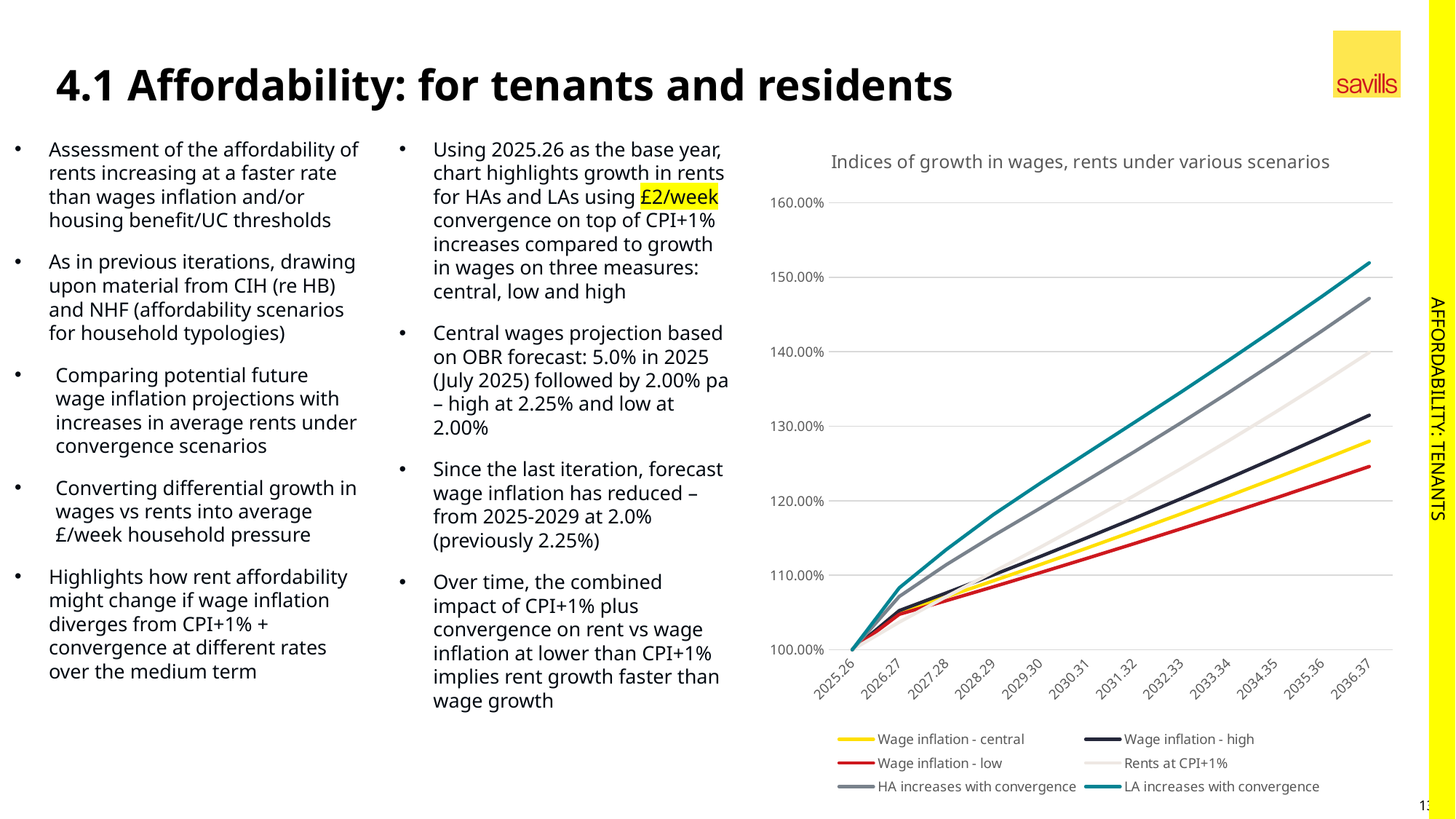
What kind of chart is shown on the slide? line chart How many series does the chart legend list? 6 What is the value of all series in the base year 2025.26? 100.00% Is the value for Wage inflation - central in 2036.37 greater or less than 130.00%? less Is the value for Wage inflation - low in 2036.37 greater or less than 120.00%? greater In 2036.37, which is larger: LA increases with convergence or HA increases with convergence? LA increases with convergence Which series has the highest value in 2036.37? LA increases with convergence Do the series values rise or fall from 2025.26 to 2036.37? rise Which series has the lowest value in 2036.37? Wage inflation - low Is the value for HA increases with convergence in 2036.37 greater or less than 150.00%? less How many years are shown along the x axis of the chart? 12 What is the title of the chart? Indices of growth in wages, rents under various scenarios